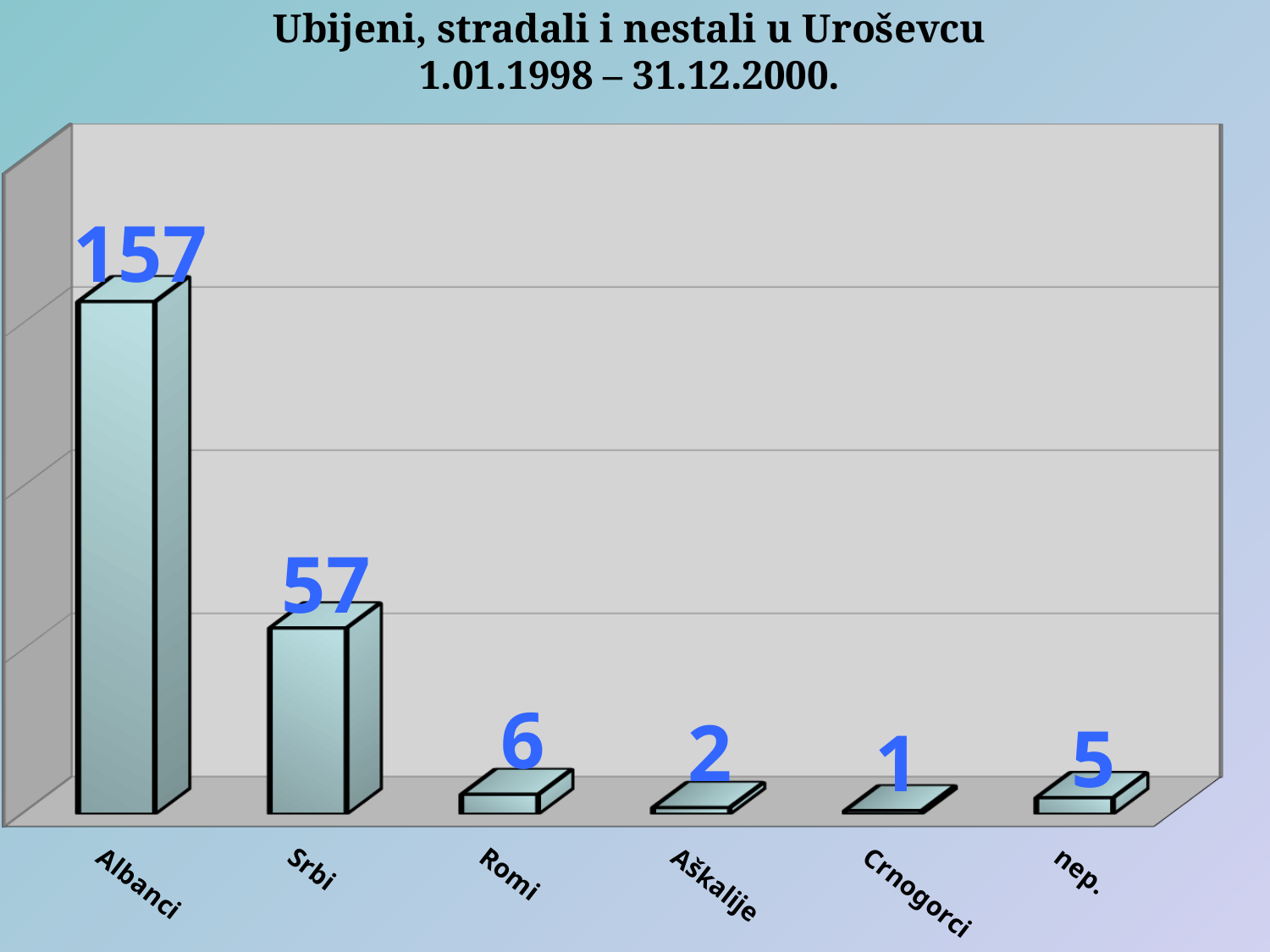
Which is larger, the value for Romi or the value for nep.? Romi What is the value for Albanci? 157 What kind of chart is shown on the slide? Bar chart What is the value for Crnogorci? 1 What is the value for nep.? 5 What is the value for Srbi? 57 How many categories are shown in the chart? 6 Which category has the lowest value? Crnogorci Which category has the highest value? Albanci What is the difference between the values for Albanci and Srbi? 100 What is the value for Aškalije? 2 What is the value for Romi? 6